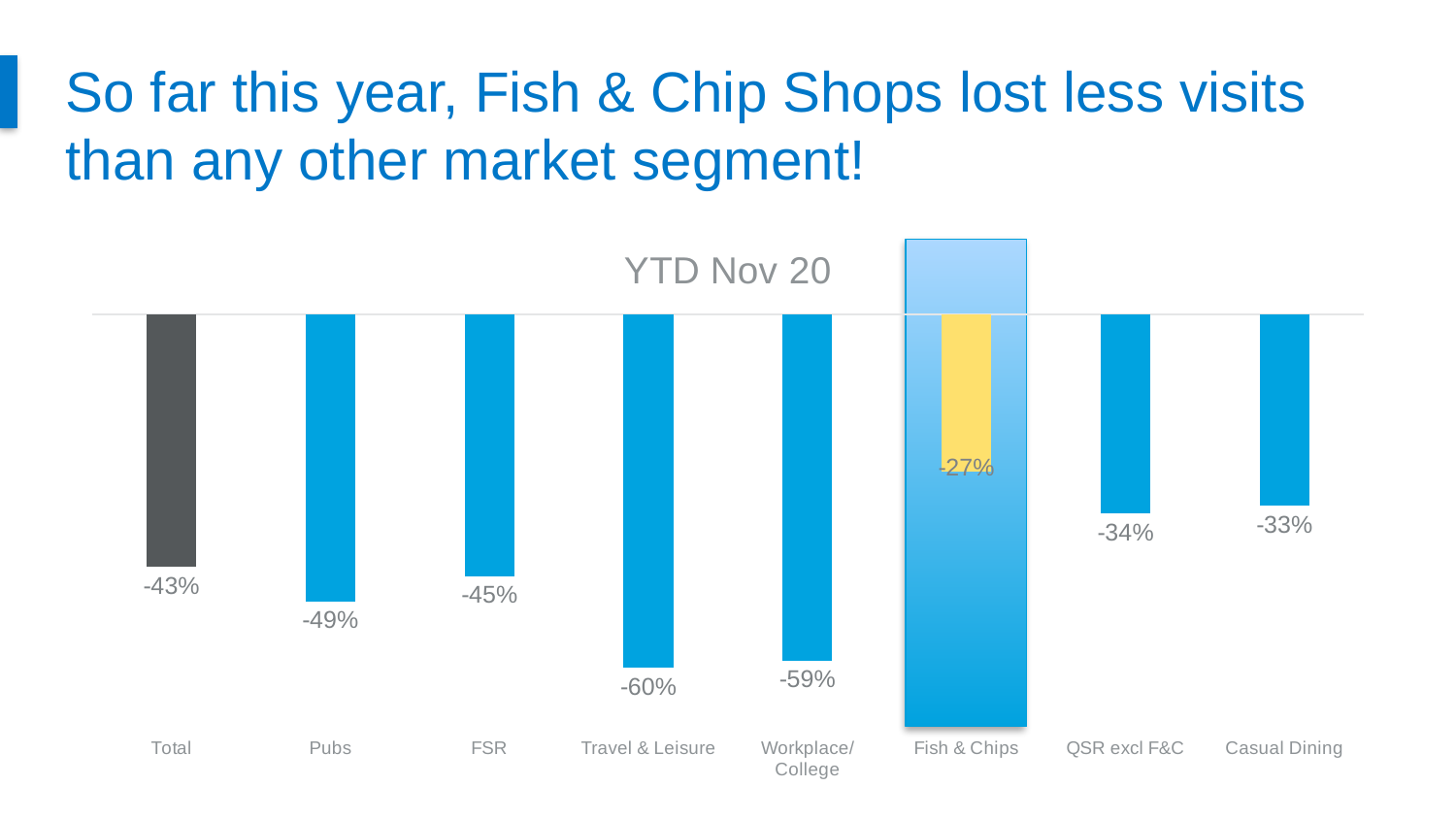
What is the value shown for Travel & Leisure? -60% Which shows a larger decline, Pubs or FSR? Pubs How many categories are plotted on the chart? 8 What is the value shown for Pubs? -49% Which category has the lowest value (largest decline)? Travel & Leisure Which category has the highest value (smallest decline)? Fish & Chips What is the value shown for Fish & Chips? -27% What kind of chart is shown on the slide? Bar chart What is the title of the chart? YTD Nov 20 What is the difference in percentage points between the Travel & Leisure value and the Fish & Chips value? 33 percentage points What is the value shown for the Total bar? -43% Which shows a larger decline, QSR excl F&C or Casual Dining? QSR excl F&C